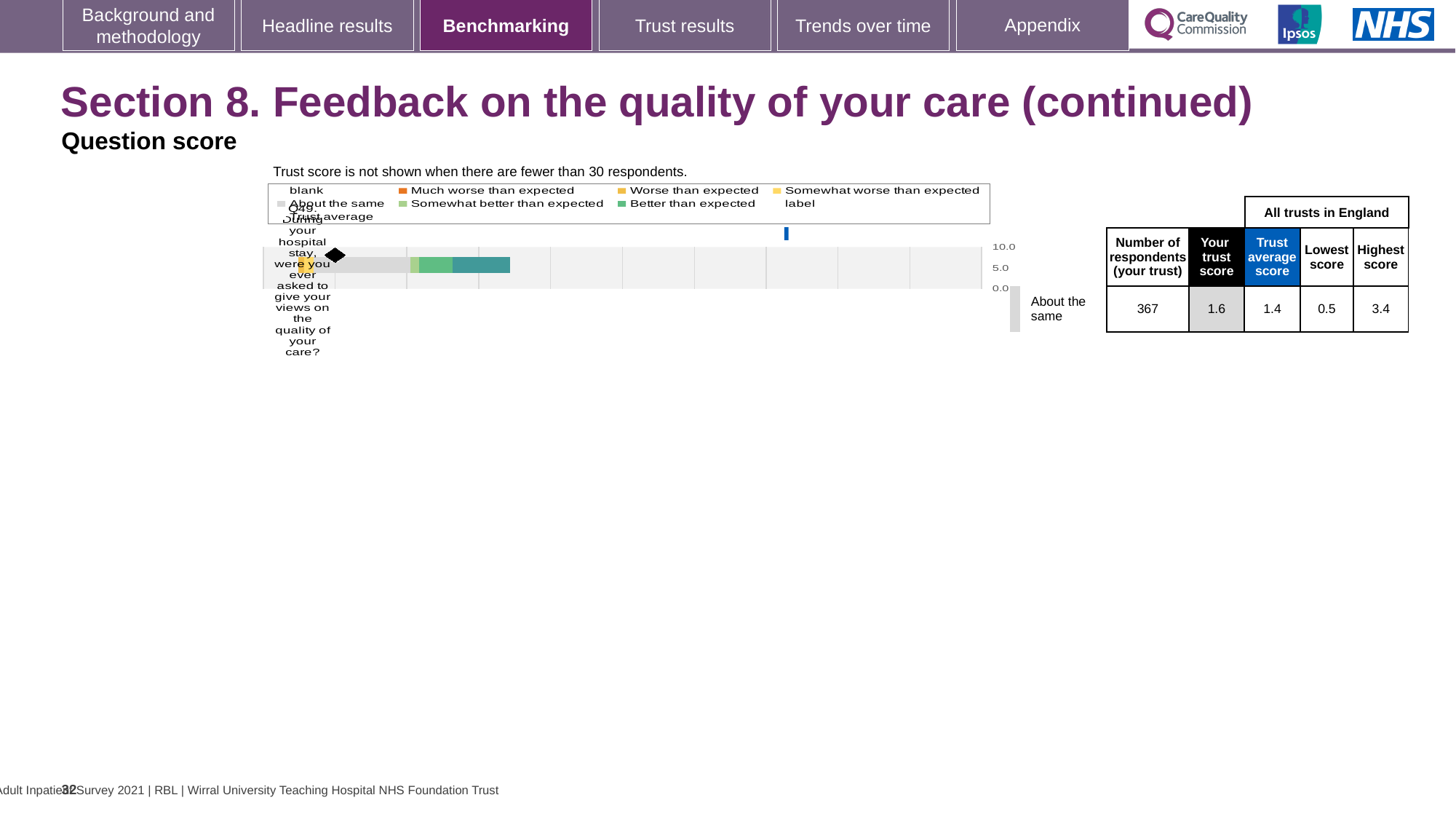
What is the difference between the trust's score and the trust average score for Q49? 0.2 What is the lowest score across all trusts in England for Q49? 0.5 What kind of chart is used to show the Q49 benchmarking result? Bar chart What is the highest score across all trusts in England for Q49? 3.4 How many respondents from the trust answered Q49? 367 Which is larger for Q49: the trust's score or the trust average score? The trust's score Is the trust's score for Q49 greater or less than 5.0 on the chart axis? less What is the difference between the highest and lowest scores across all trusts in England for Q49? 2.9 What is the trust score for Q49 shown in the table next to the chart? 1.6 How many questions are plotted on the chart? 1 What is the trust average score for Q49? 1.4 How is the trust's result for Q49 categorised relative to expectations? About the same